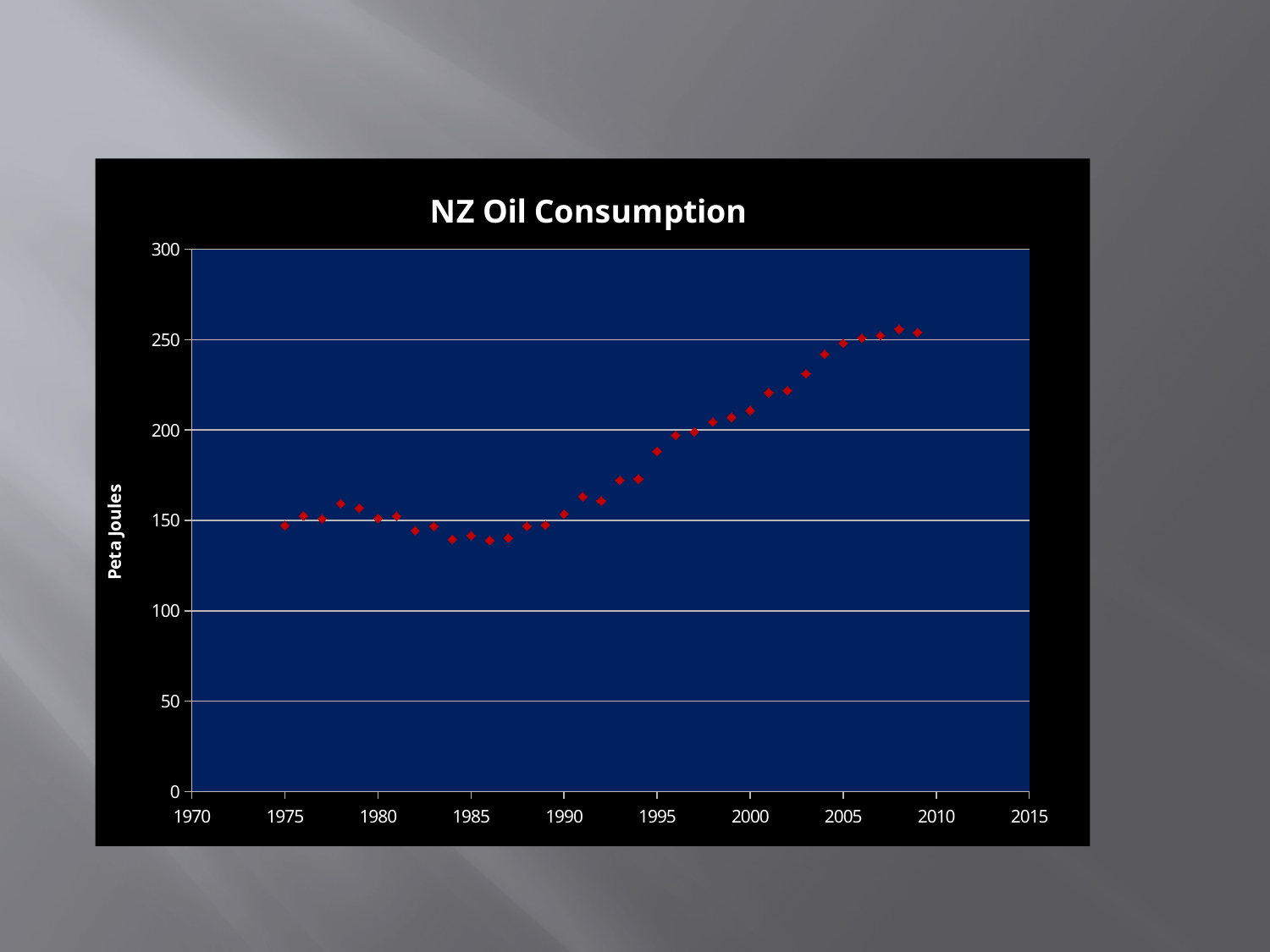
Which year has the larger value, 1978 or 1986? 1978 Do the values generally rise or fall between 1978 and 1986? fall Which year has the larger value, 1985 or 2005? 2005 What kind of chart is shown on the slide? scatter chart Is the value for 2005 greater or less than 200? greater What is the label on the vertical axis of the chart? Peta Joules Do the values generally rise or fall between 1990 and 2008? rise Is the value for 2000 greater or less than 200? greater Is the value for 1985 greater or less than 150? less What is the title of the chart? NZ Oil Consumption